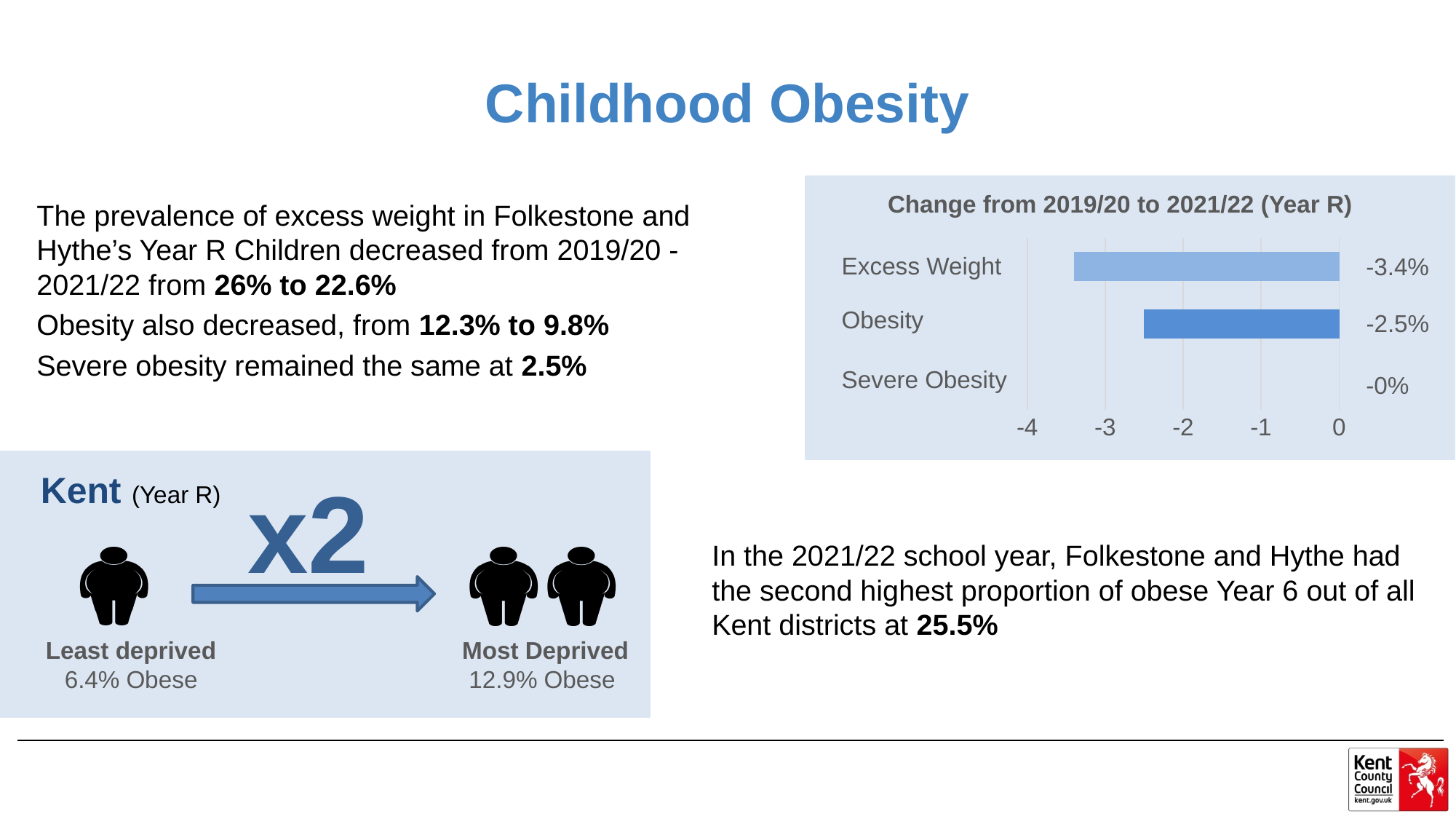
Which category shows the largest decrease in the chart? Excess Weight What is the title of the chart on the slide? Change from 2019/20 to 2021/22 (Year R) Is the value for Excess Weight in the chart less than -3 or greater than -3? less What is the value for Severe Obesity in the chart? -0% What is the difference between the Excess Weight and Obesity values in the chart? 0.9 percentage points What is the value for Excess Weight in the chart? -3.4% What is the lowest value shown on the x axis of the chart? -4 Which category shows the smallest change in the chart? Severe Obesity How many categories does the chart show? 3 What type of chart is shown on the slide? bar chart What is the value for Obesity in the chart? -2.5% Which has a larger decrease in the chart, Excess Weight or Obesity? Excess Weight